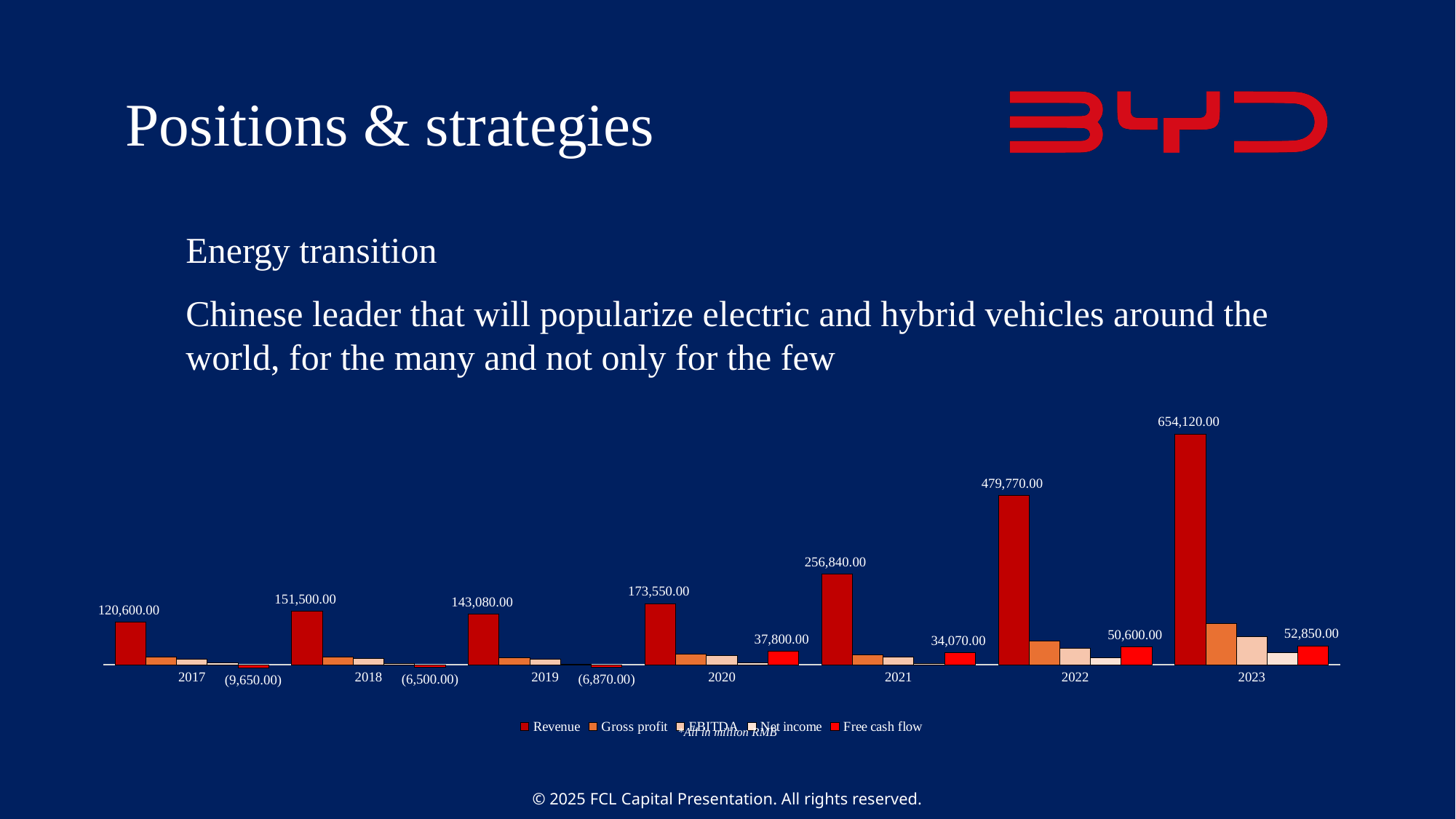
How many years are shown on the x axis? 7 Which year has the lowest Revenue? 2017 Does Revenue rise or fall from 2020 to 2023? Rise What is the Free cash flow value for 2018? (6,500.00) What is the Free cash flow value for 2020? 37,800.00 How many series does the legend list? 5 What is the Revenue value for 2017? 120,600.00 Which year has the larger Revenue, 2018 or 2019? 2018 What is the difference in Revenue between 2023 and 2022? 174,350.00 What is the Revenue value for 2023? 654,120.00 What kind of chart is shown on the slide? Bar chart Which year has the highest Revenue? 2023